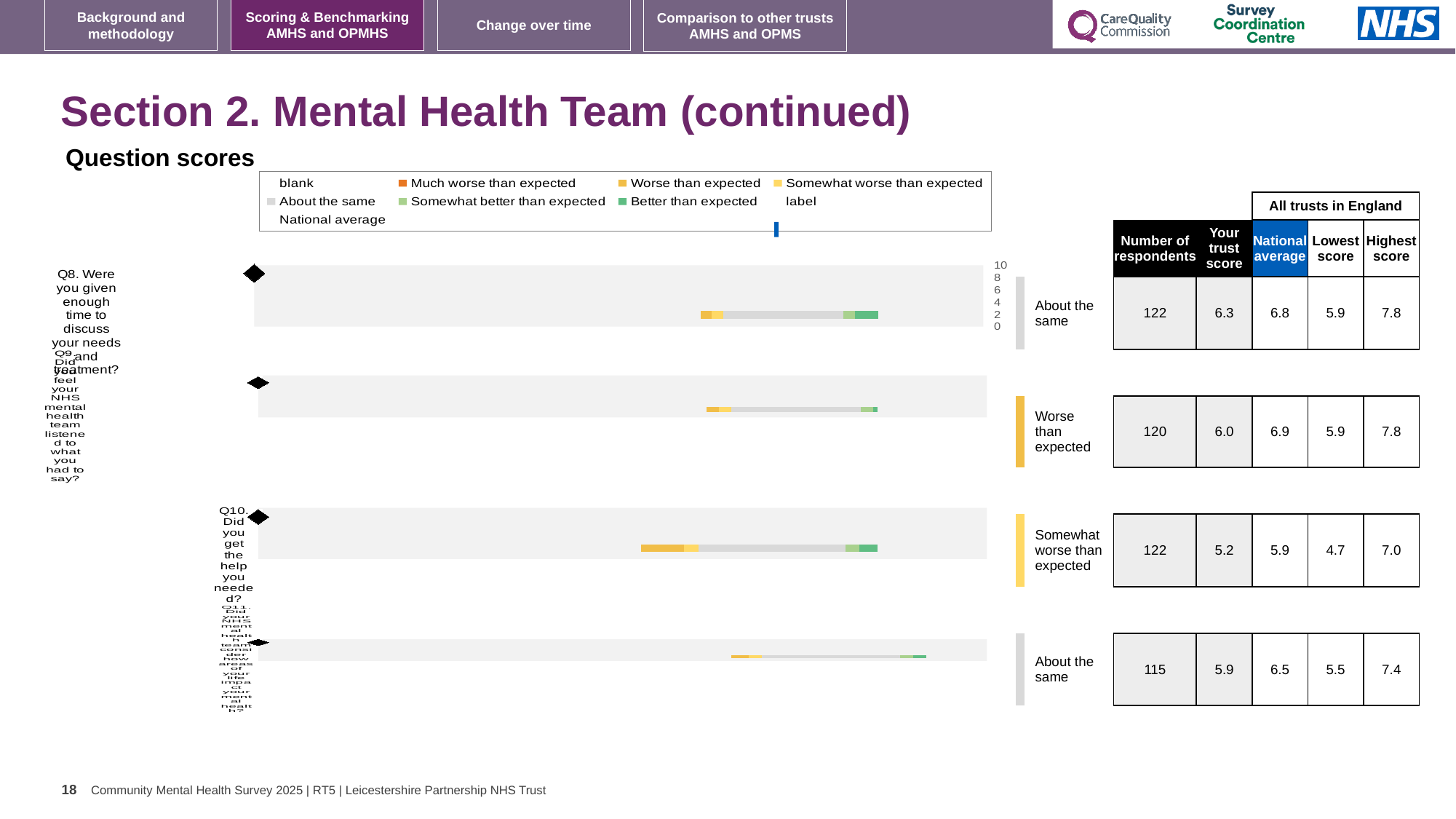
In the legend, which colour represents 'Better than expected'? green In the table, what is the lowest score for the third row (Q10)? 4.7 In the table, is the national average for the second row (Q9) larger or smaller than your trust score? larger What kind of chart is used for the Q8 question score? bar chart How many question charts (Q8 to Q11) are shown on the slide? 4 In the legend, which colour represents 'Much worse than expected'? orange In the table, what is the highest score for the fourth row (Q11, About the same)? 7.4 In the table, what is the difference between the national average and your trust score for the first row (Q8)? 0.5 In the table, which row has the lowest 'Your trust score'? Q10 (Somewhat worse than expected), 5.2 In the table, what is 'Your trust score' for the second row (Q9, Worse than expected)? 6.0 In the table, what is the number of respondents for the first row (Q8, About the same)? 122 In the table, what is the national average for the third row (Q10, Somewhat worse than expected)? 5.9